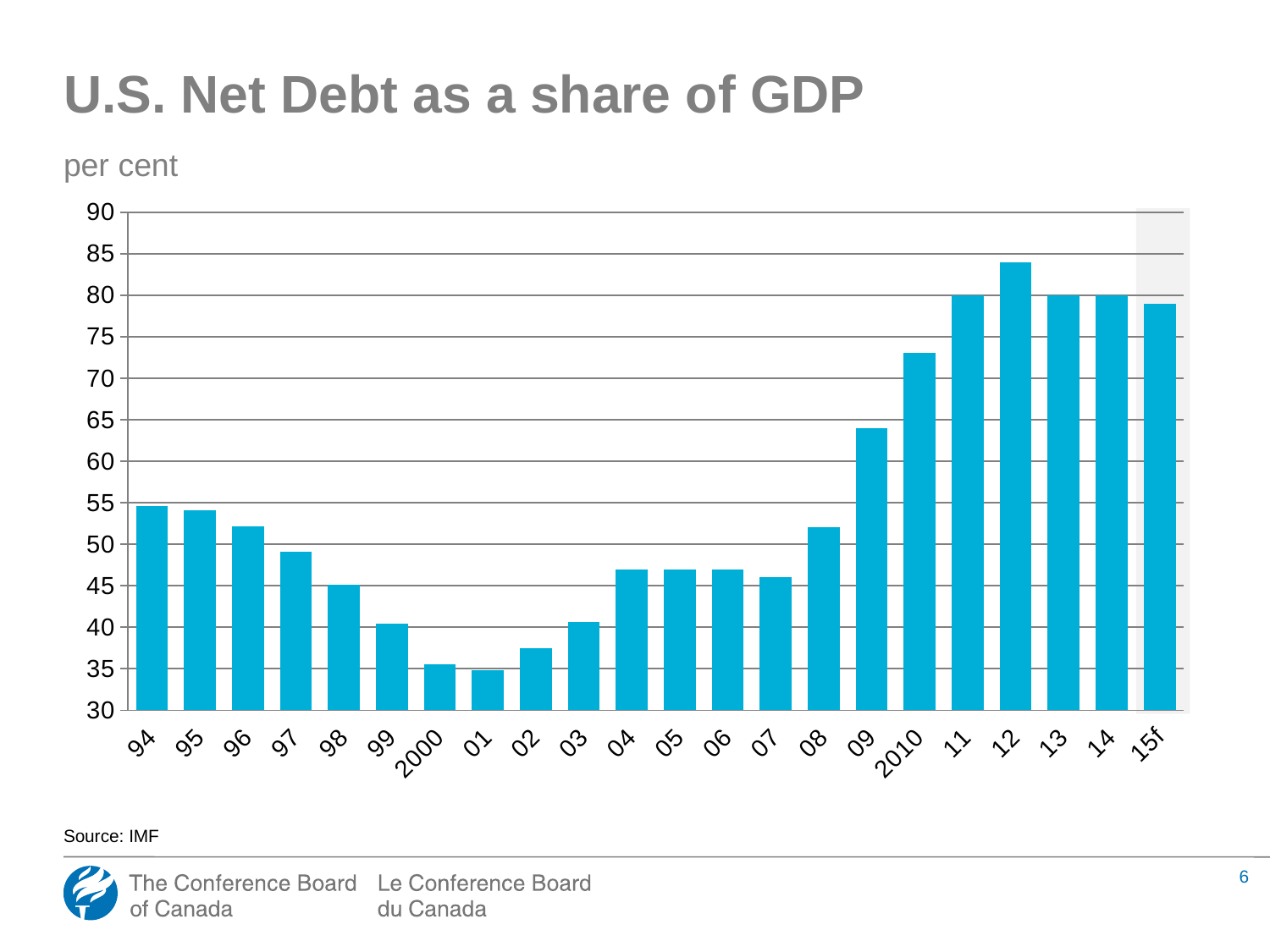
Is the value for 09 greater or less than 60? greater What kind of chart is shown on the slide? bar chart Is the value for 2010 greater or less than 70? greater Is the value for 07 greater or less than 50? less What is the title of the chart? U.S. Net Debt as a share of GDP Which year has the highest net debt as a share of GDP? 12 What is the value for 11? 80 What is the value for 13? 80 How many years (bars) are plotted in the chart? 22 Do the values rise or fall from 94 to 01? fall Which is larger, the value for 12 or the value for 11? 12